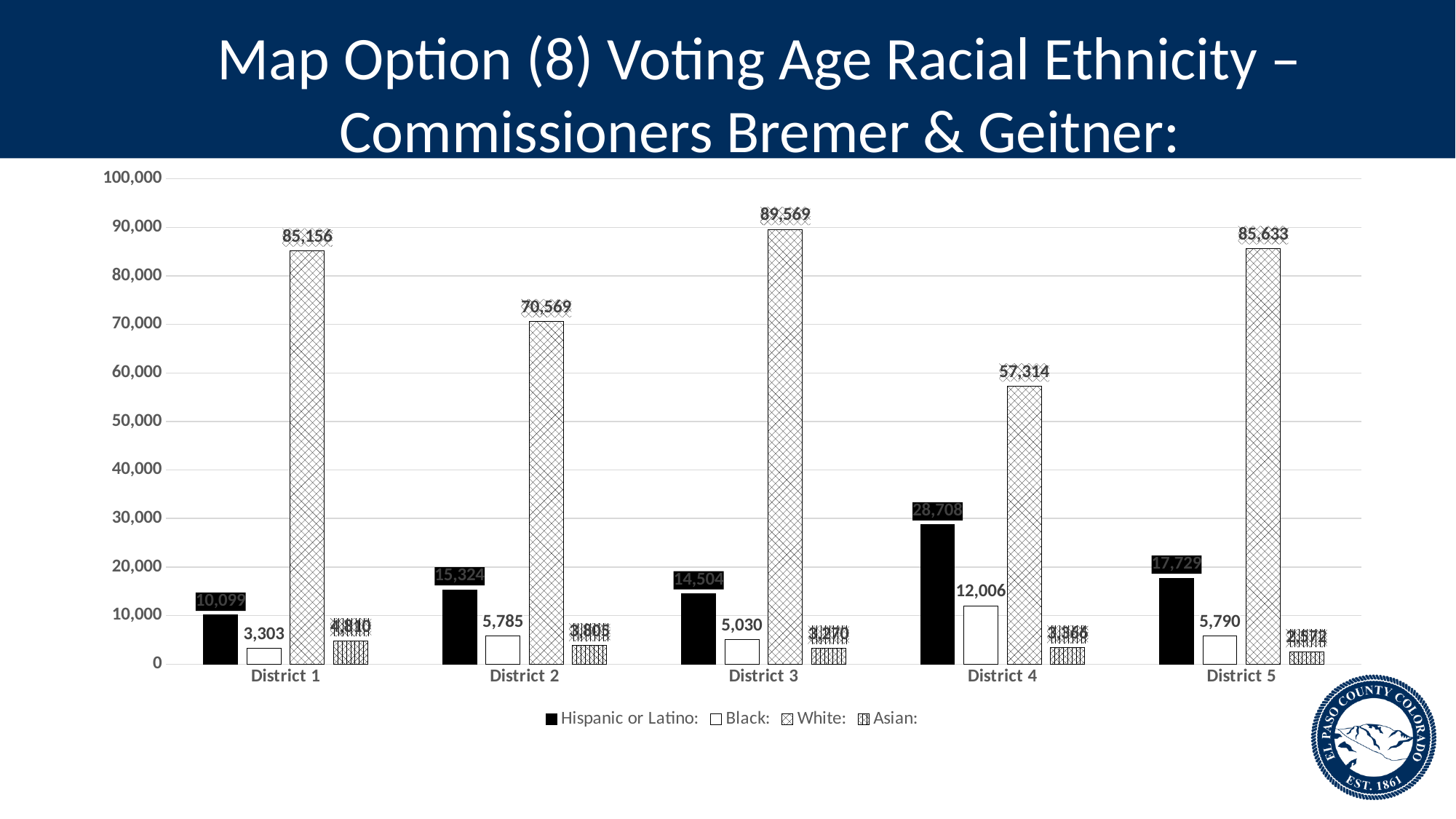
Which is larger, the Hispanic or Latino value for District 2 or for District 3? District 2 How many series does the legend list? 4 Is the White value for District 2 greater or less than 80,000? less What is the Black value for District 2? 5,785 What is the difference between the Black value for District 4 and the Black value for District 1? 8,703 What is the Hispanic or Latino value for District 4? 28,708 How many districts are shown on the x axis? 5 What is the White value for District 3? 89,569 Which district has the highest Hispanic or Latino value? District 4 What kind of chart is shown on the slide? bar chart Which district has the highest White value? District 3 Which district has the lowest White value? District 4